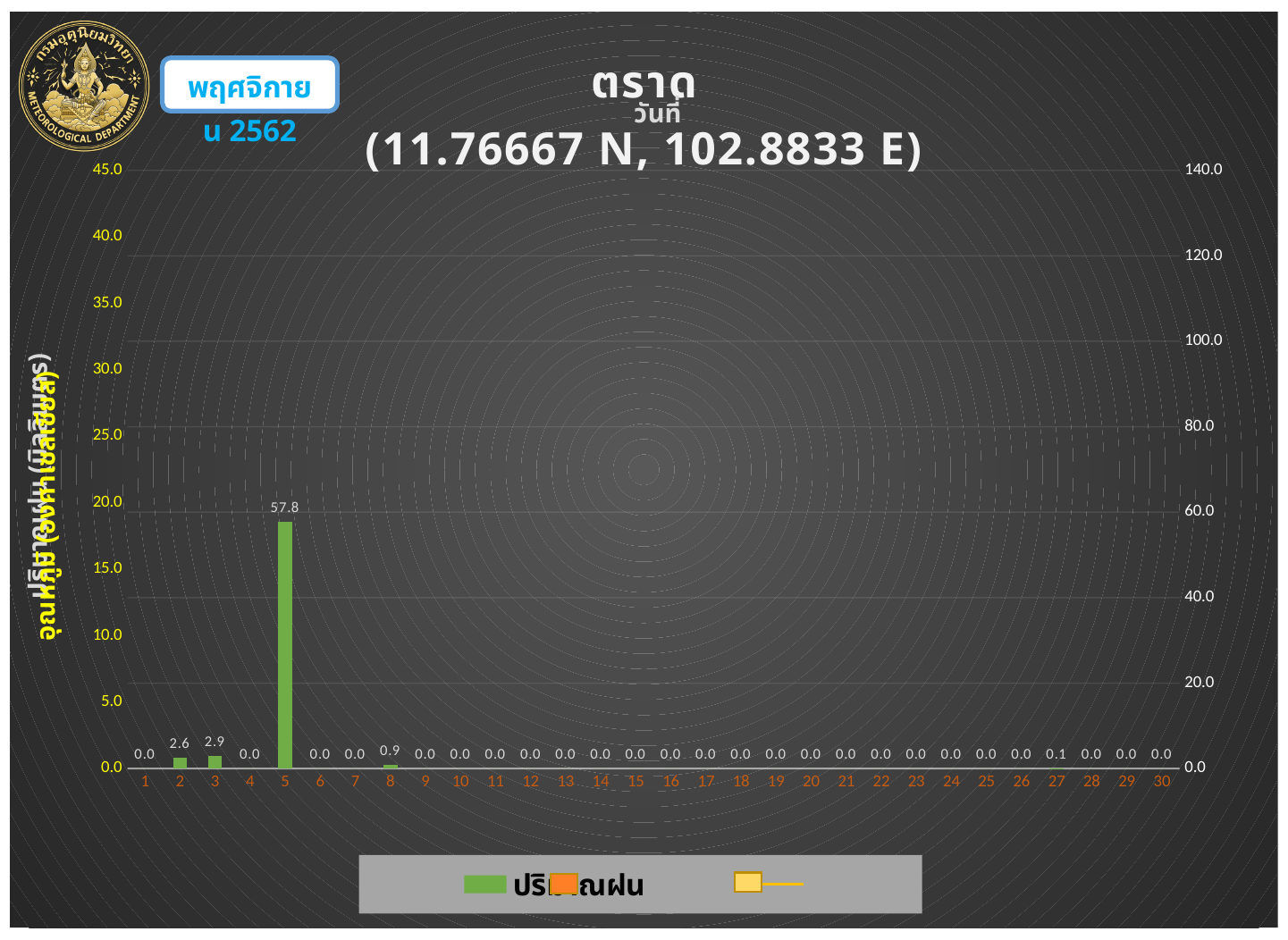
Which is larger, the value for day 2 or the value for day 8? day 2 What is the value shown for day 3? 2.9 What is the difference between the values for day 5 and day 3? 54.9 What coordinates are given in the chart title? 11.76667 N, 102.8833 E What is the rainfall value shown for day 5? 57.8 What is the value shown for day 8? 0.9 How many days are shown on the x axis? 30 What kind of chart is shown on the slide? bar chart What is the difference between the values for day 3 and day 2? 0.3 What is the value shown for day 27? 0.1 What is the value shown for day 2? 2.6 Which day has the highest value? 5